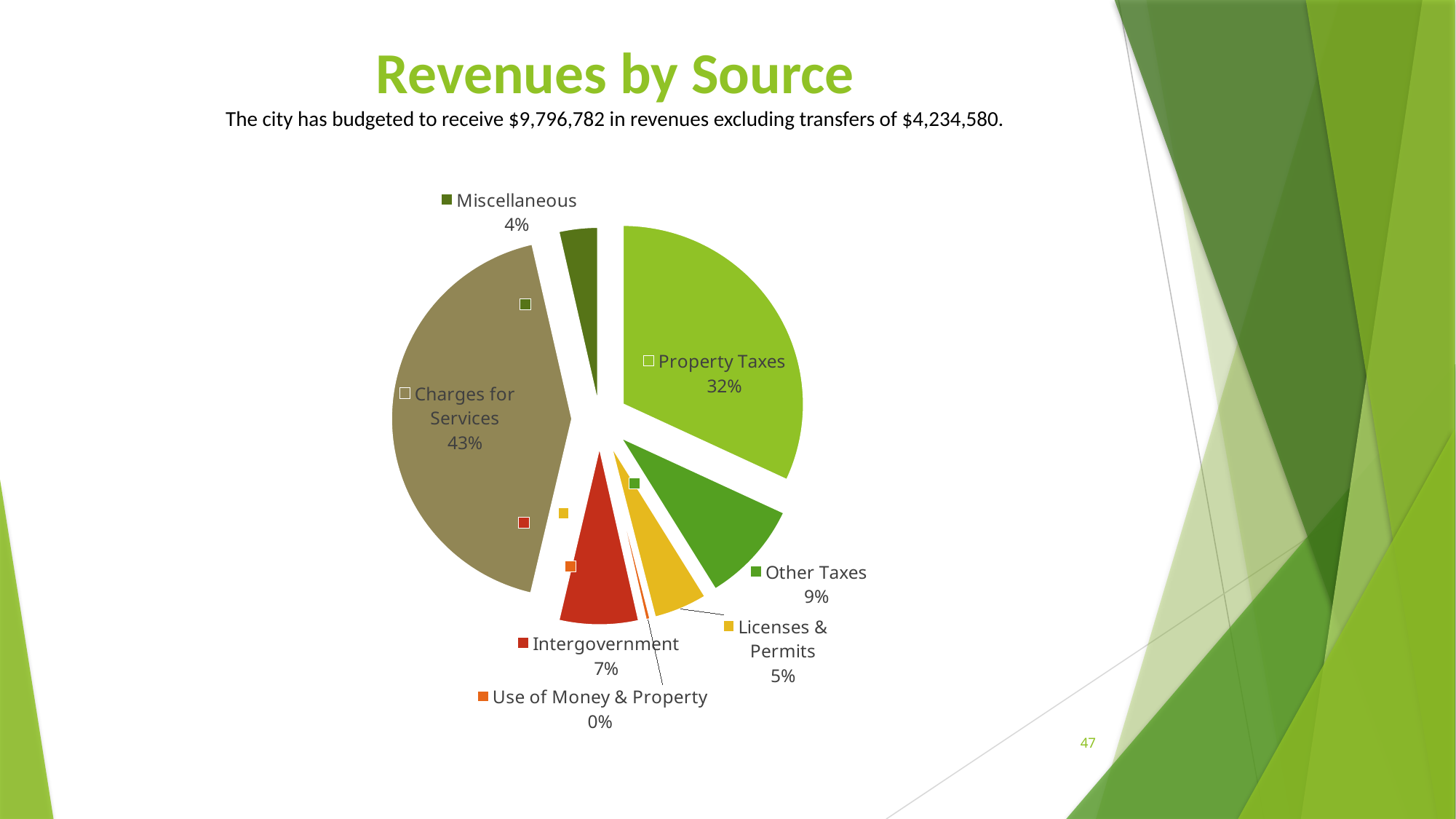
What share of revenues comes from Property Taxes? 32% Which revenue source has the largest share of the pie? Charges for Services What type of chart is shown on the slide? Pie chart What percentage is shown for Use of Money & Property? 0% Which is larger, the share for Intergovernment or the share for Miscellaneous? Intergovernment What share of revenues comes from Charges for Services? 43% What is the title of the chart on the slide? Revenues by Source What is the difference in percentage points between Charges for Services and Property Taxes? 11 percentage points What percentage is shown for Other Taxes? 9% Which revenue source has the smallest share of the pie? Use of Money & Property What percentage is shown for Licenses & Permits? 5% How many revenue sources are shown in the pie chart? 7